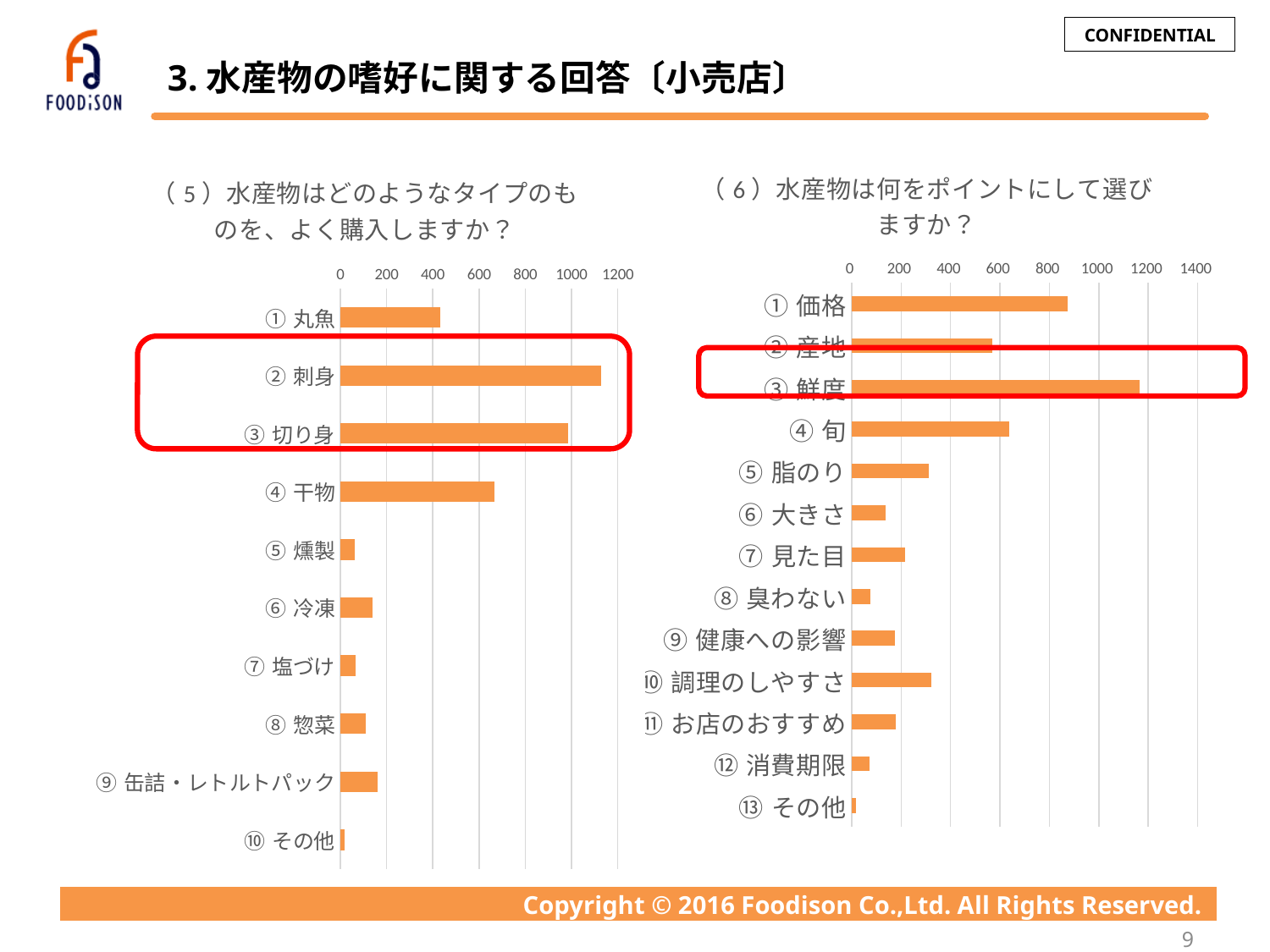
In the left chart (5), which is larger, ① 丸魚 or ⑥ 冷凍? ① 丸魚 In the right chart (6), which category has the lowest value? ⑬ その他 In the right chart (6), which is larger, ④ 旬 or ② 産地? ④ 旬 What kind of chart is the left chart, (5) 水産物はどのようなタイプのものを、よく購入しますか？? bar chart In the left chart (5), is the value for ④ 干物 greater or less than 800? less In the right chart (6), how many categories are shown? 13 In the left chart (5), how many categories are shown? 10 In the right chart (6), which category has the highest value? ③ 鮮度 In the right chart (6), is the value for ① 価格 greater or less than 800? greater In the left chart (5), which category has the highest value? ② 刺身 In the left chart (5), is the value for ② 刺身 greater or less than 1000? greater In the left chart (5), which category has the lowest value? ⑩ その他